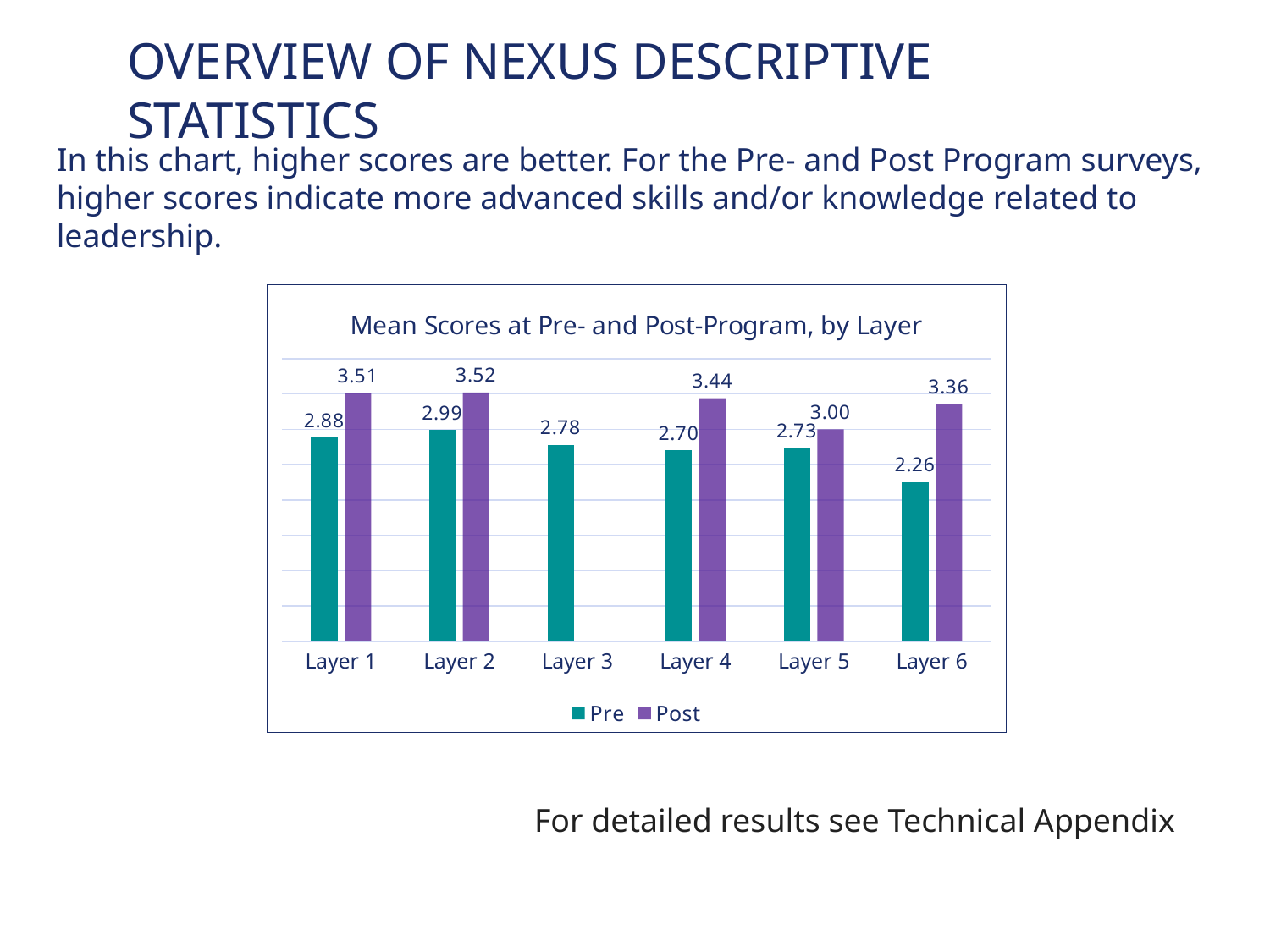
What is the difference between the Post and Pre scores for Layer 6? 1.10 Which layer has the highest Post score? Layer 2 What is the difference between the Pre scores for Layer 2 and Layer 4? 0.29 How many layers are shown on the x axis? 6 How many series does the legend list? 2 What is the Pre score for Layer 1? 2.88 What is the Pre score for Layer 6? 2.26 What kind of chart is shown on the slide? Bar chart Which is larger, the Post score for Layer 5 or the Post score for Layer 6? Post score for Layer 6 What is the Post score for Layer 4? 3.44 Which layer has no Post bar shown? Layer 3 Which layer has the lowest Pre score? Layer 6